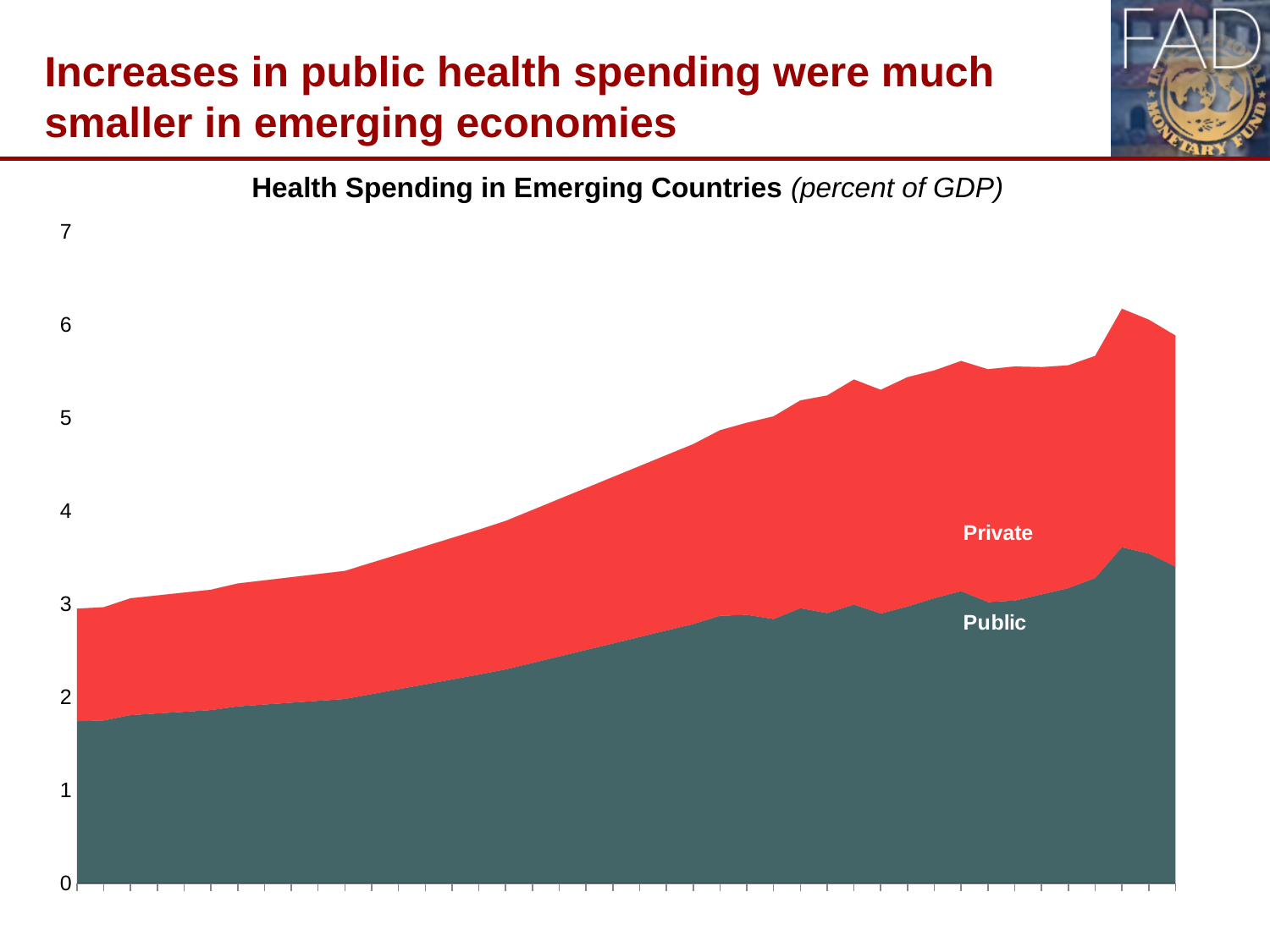
Does total health spending rise or fall from the left to the right of the chart? Rise How many series are plotted in the chart? 2 At the right end of the chart, which is larger: the Public or the Private component of health spending? Public Is public health spending at the left end of the chart greater or less than 2? less Does public health spending rise or fall from the left to the right of the chart? Rise In what units are the values in the chart expressed? Percent of GDP Is public health spending at the right end of the chart greater or less than 3? greater Is total health spending at the right end of the chart greater or less than 5? greater What kind of chart is shown on the slide? Stacked area chart What is the title of the chart? Health Spending in Emerging Countries What are the names of the two series shown in the chart? Private and Public